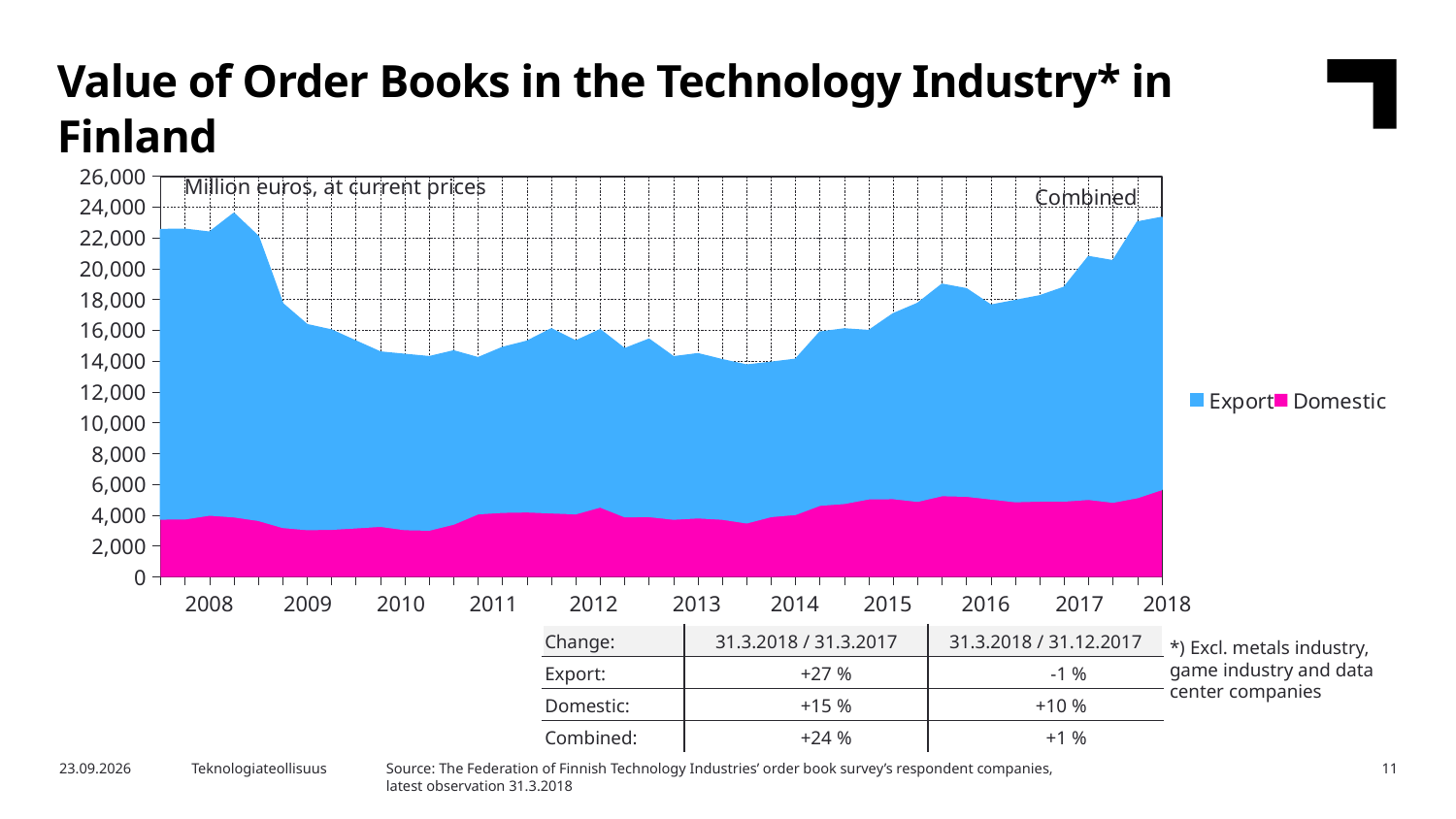
How many year labels are shown on the x axis? 11 Does the combined value of order books rise or fall between 2014 and 2018? rise Which two series are listed in the chart's legend? Export and Domestic What unit label is shown inside the chart area? Million euros, at current prices Is the combined value of order books at the start of 2008 greater or less than 20,000? greater Is the combined value of order books at 2018 greater or less than 22,000? greater What kind of chart is shown on the slide? Stacked area chart Which series is larger throughout the chart, Export or Domestic? Export Is the Domestic value at 2018 greater or less than 4,000? greater How many series does the chart's legend list? 2